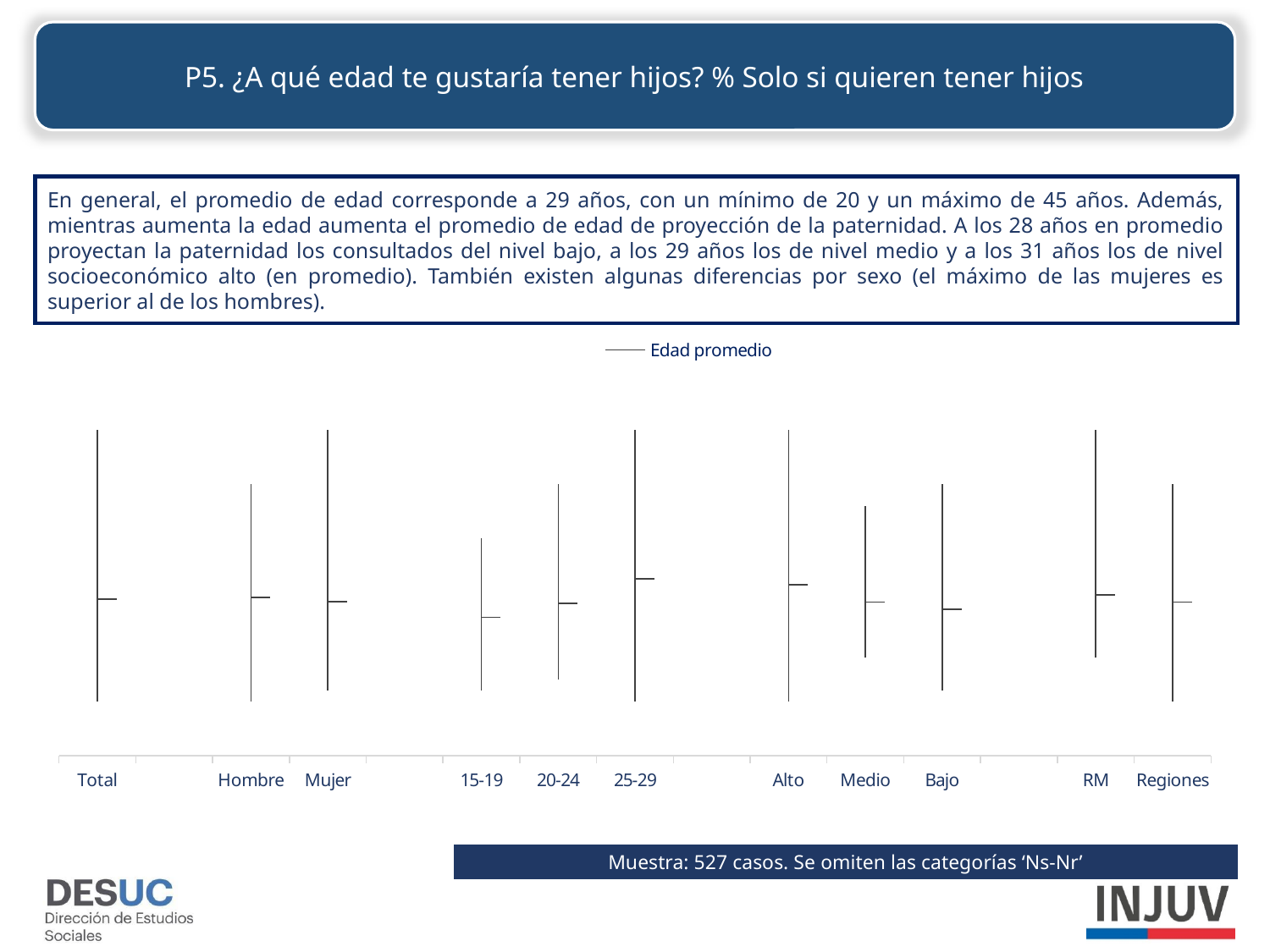
How many categories are shown along the x axis of the chart? 11 Which has the higher average age (Edad promedio), Alto or Medio? Alto Which has the higher average age (Edad promedio), RM or Regiones? RM Which has the higher maximum value, Hombre or Mujer? Mujer What is the title of the chart on the slide? P5. ¿A qué edad te gustaría tener hijos? % Solo si quieren tener hijos What is the name of the series shown in the chart legend? Edad promedio Across the age groups 15-19, 20-24 and 25-29, does the average age rise or fall? rise How many series does the chart legend list? 1